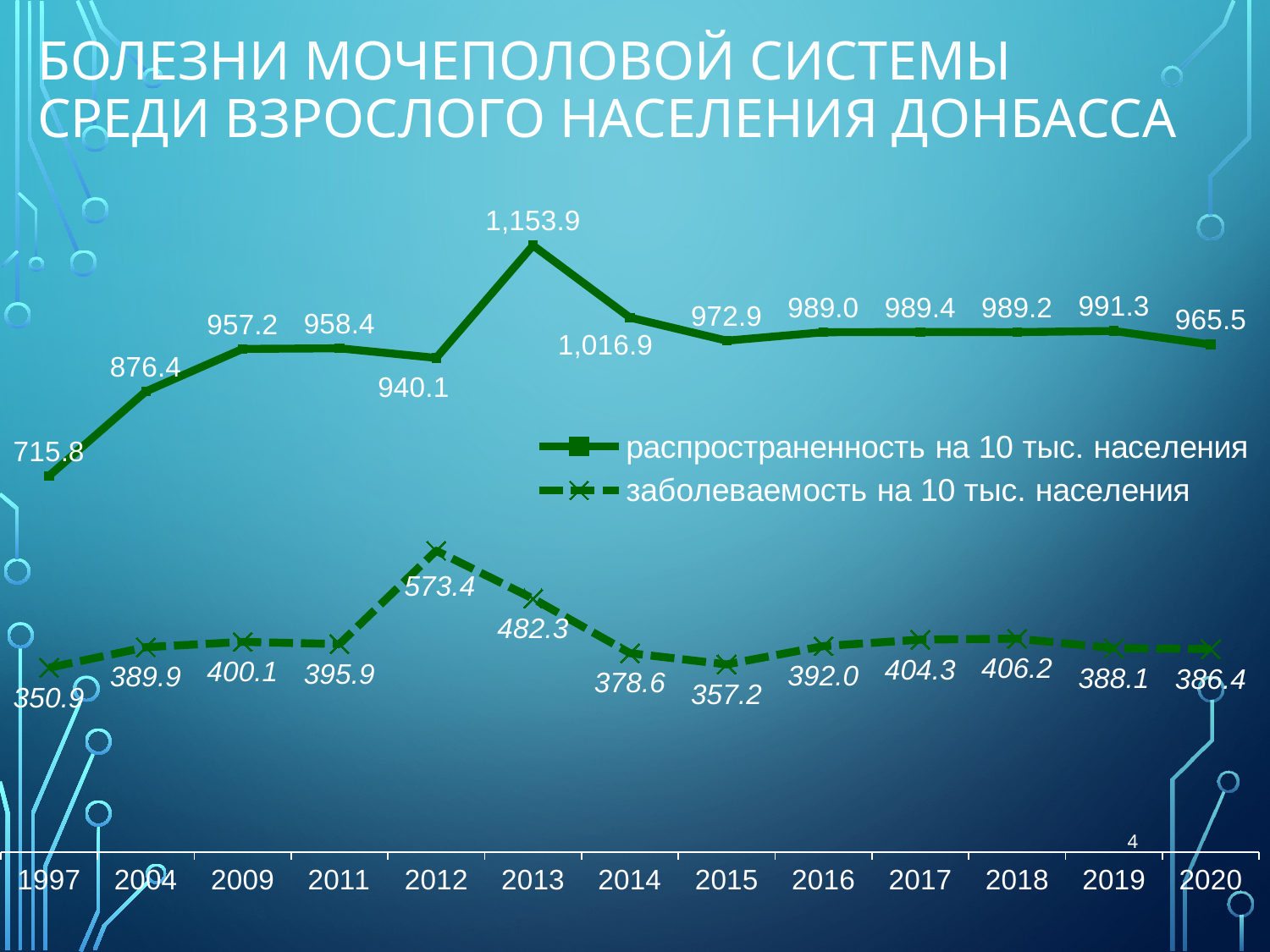
What is the value of распространенность на 10 тыс. населения in 1997? 715.8 What is the value of заболеваемость на 10 тыс. населения in 2012? 573.4 What is the difference between распространенность на 10 тыс. населения in 2013 and in 2014? 137.0 Which is larger: заболеваемость на 10 тыс. населения in 2018 or in 2019? 2018 How many series does the legend list? 2 What is the value of распространенность на 10 тыс. населения in 2013? 1,153.9 What type of chart is shown on the slide? line chart How many years are shown on the x axis? 13 Does распространенность на 10 тыс. населения rise or fall from 1997 to 2009? rise In which year is заболеваемость на 10 тыс. населения lowest? 1997 In which year is распространенность на 10 тыс. населения highest? 2013 What is the value of заболеваемость на 10 тыс. населения in 2020? 386.4